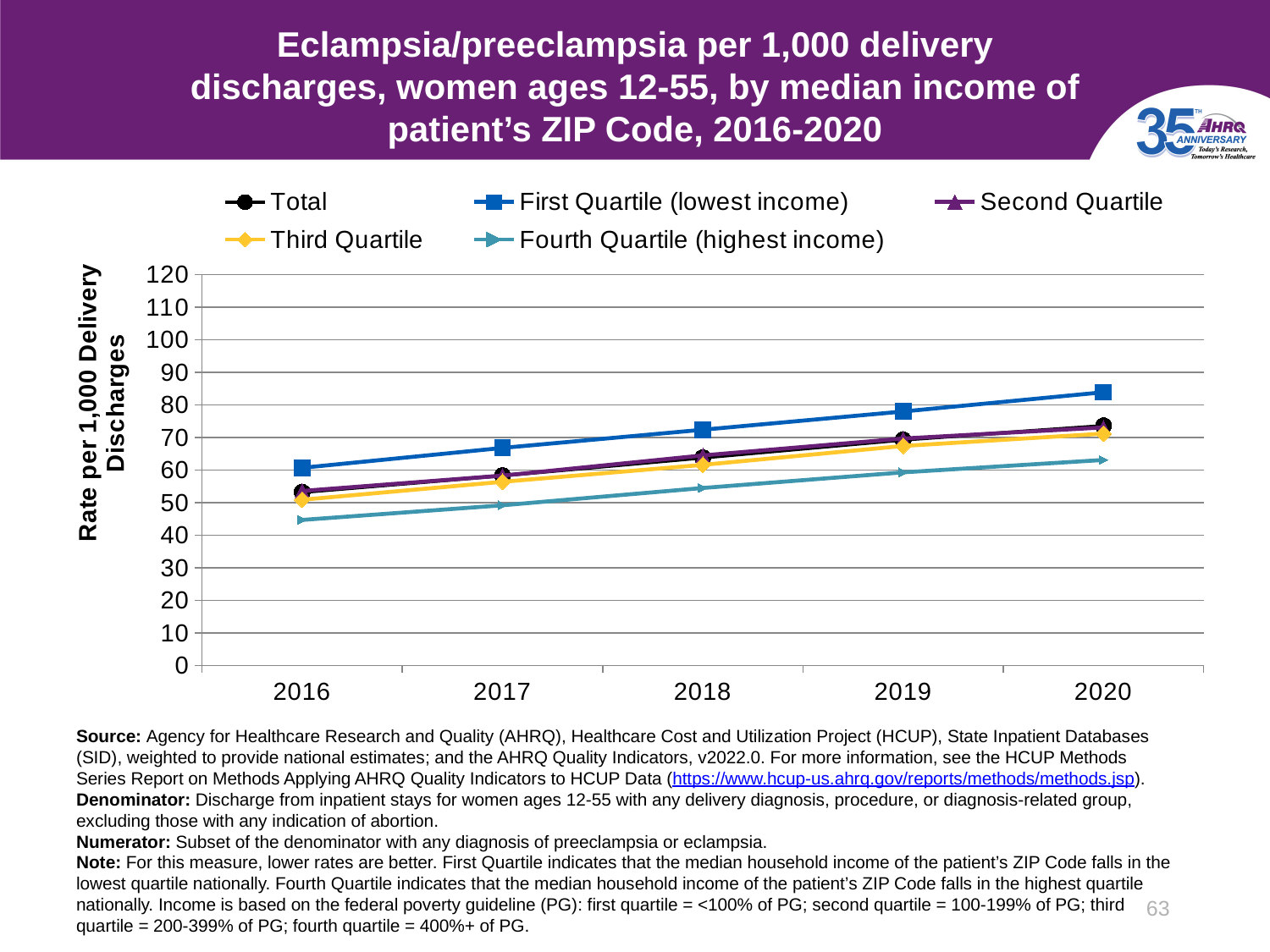
What is the label of the y axis? Rate per 1,000 Delivery Discharges Is the value for Fourth Quartile (highest income) in 2018 greater or less than 50? greater Is the value for Fourth Quartile (highest income) in 2016 greater or less than 50? less What kind of chart is shown on the slide? Line chart Does the First Quartile (lowest income) rate rise or fall from 2016 to 2020? Rise Is the value for Total in 2020 greater or less than 70? greater How many series does the legend list? 5 How many years are plotted along the x axis? 5 Which series has the highest rate in 2020? First Quartile (lowest income) In 2019, which is larger: the First Quartile (lowest income) rate or the Fourth Quartile (highest income) rate? First Quartile (lowest income) Which series has the lowest rate in 2016? Fourth Quartile (highest income)